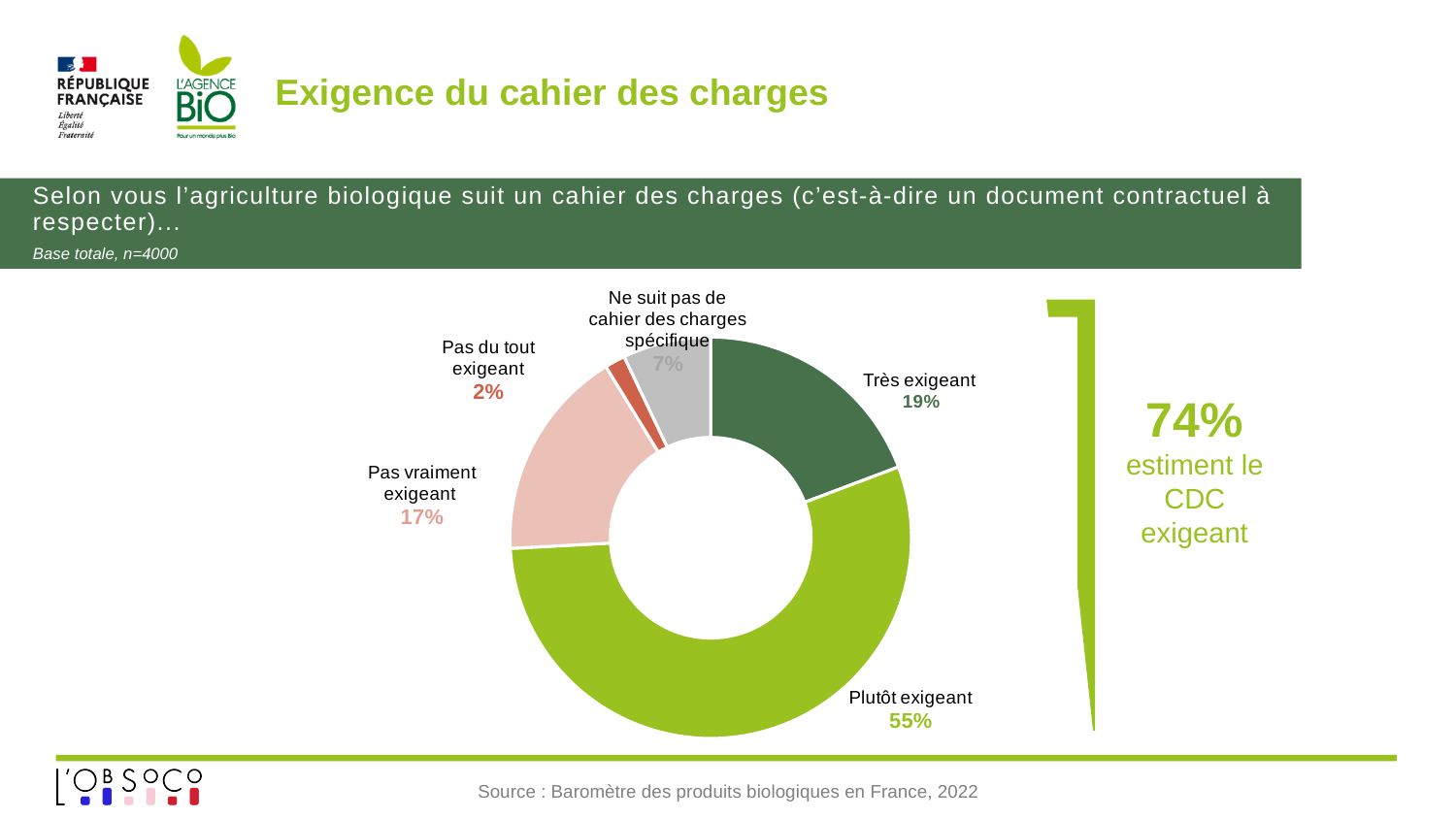
What percentage of respondents answered "Très exigeant"? 19% Which category has the smallest share of the pie? Pas du tout exigeant What kind of chart is shown on the slide? Pie chart (donut) Which is larger, the share for "Très exigeant" or the share for "Pas vraiment exigeant"? Très exigeant What percentage of respondents answered "Ne suit pas de cahier des charges spécifique"? 7% What is the combined share of "Très exigeant" and "Plutôt exigeant"? 74% What is the sample size (base) stated for the chart? n=4000 What is the difference in percentage points between "Plutôt exigeant" and "Très exigeant"? 36 Which category has the largest share of the pie? Plutôt exigeant How many categories are shown in the chart? 5 What percentage of respondents answered "Plutôt exigeant"? 55% What percentage of respondents answered "Pas vraiment exigeant"? 17%